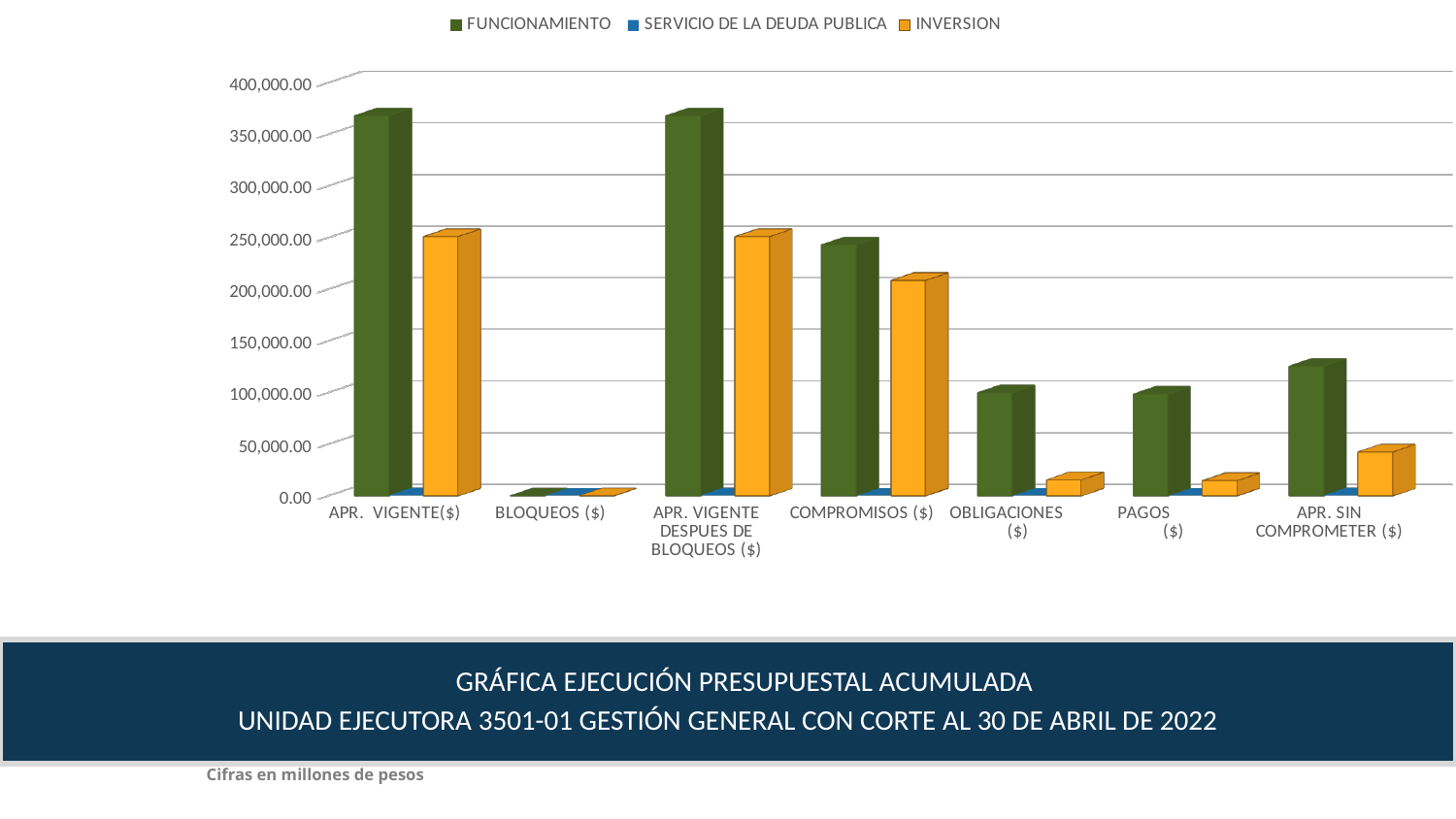
How many categories are shown along the x axis? 7 Is the INVERSION value for OBLIGACIONES ($) greater or less than 50,000.00? less Which is larger, the FUNCIONAMIENTO value for APR. SIN COMPROMETER ($) or the FUNCIONAMIENTO value for PAGOS ($)? APR. SIN COMPROMETER ($) Is the INVERSION value for COMPROMISOS ($) greater or less than 250,000.00? less What kind of chart is shown on the slide? Bar chart How many series does the legend list? 3 For COMPROMISOS ($), which series has the larger value, FUNCIONAMIENTO or INVERSION? FUNCIONAMIENTO Which series is shown in orange in the legend? INVERSION Is the FUNCIONAMIENTO value for APR. SIN COMPROMETER ($) greater or less than 100,000.00? greater Which category has the lowest FUNCIONAMIENTO value? BLOQUEOS ($)